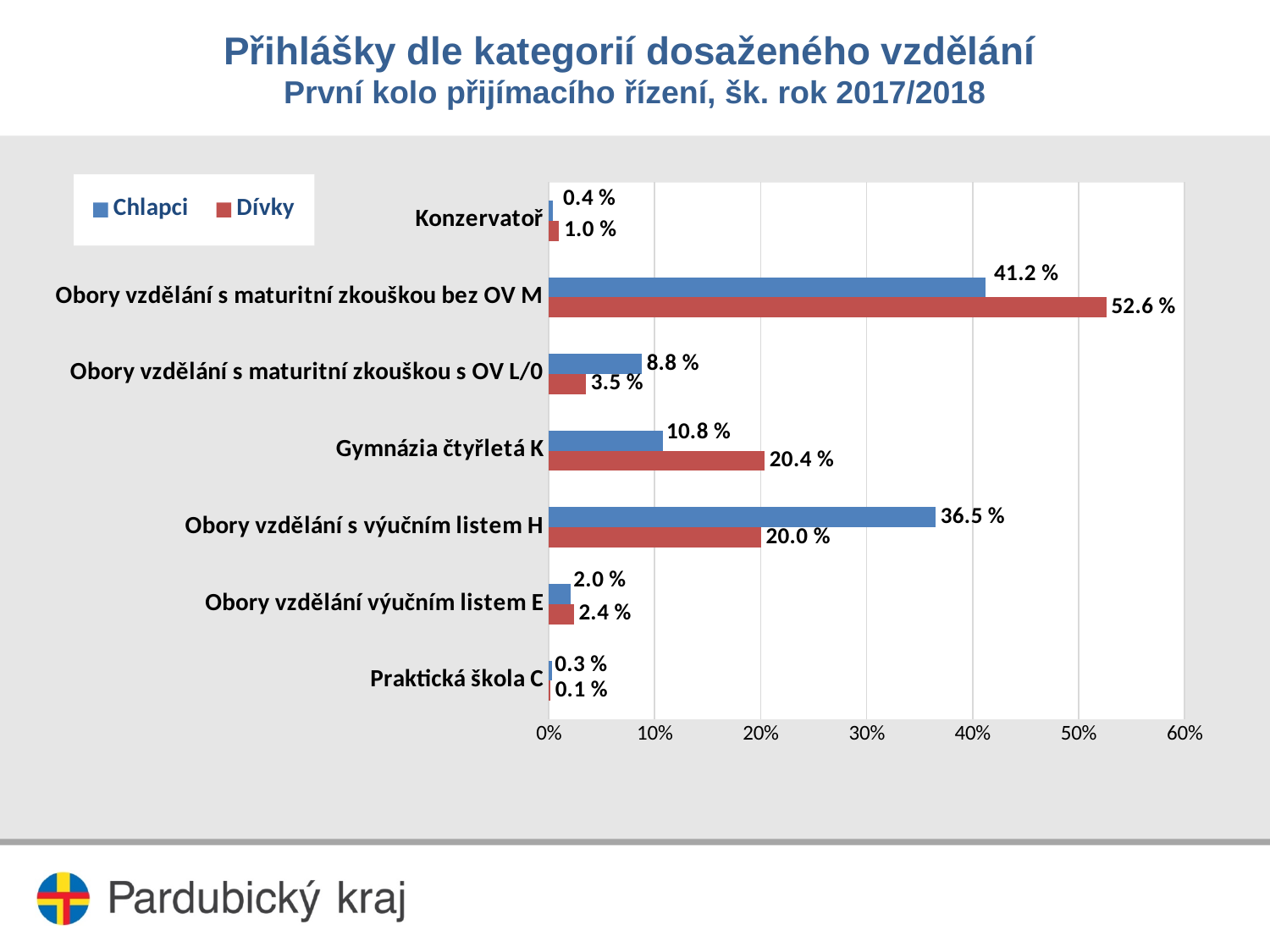
How many categories are shown on the chart? 7 Is the Dívky value for 'Obory vzdělání s maturitní zkouškou bez OV M' greater or less than 50%? greater What is the value for Dívky in the category 'Gymnázia čtyřletá K'? 20.4 % What is the difference between the Dívky and Chlapci values for 'Obory vzdělání s maturitní zkouškou bez OV M'? 11.4 % What kind of chart is shown on the slide? bar chart What is the value for Dívky in the category 'Konzervatoř'? 1.0 % Which is larger for 'Obory vzdělání s maturitní zkouškou s OV L/0': Chlapci or Dívky? Chlapci What is the value for Chlapci in the category 'Obory vzdělání s maturitní zkouškou bez OV M'? 41.2 % Which category has the highest value for Dívky? Obory vzdělání s maturitní zkouškou bez OV M How many series does the legend list? 2 Which category has the lowest value for Chlapci? Praktická škola C What is the difference between the Chlapci and Dívky values for 'Obory vzdělání s výučním listem H'? 16.5 %